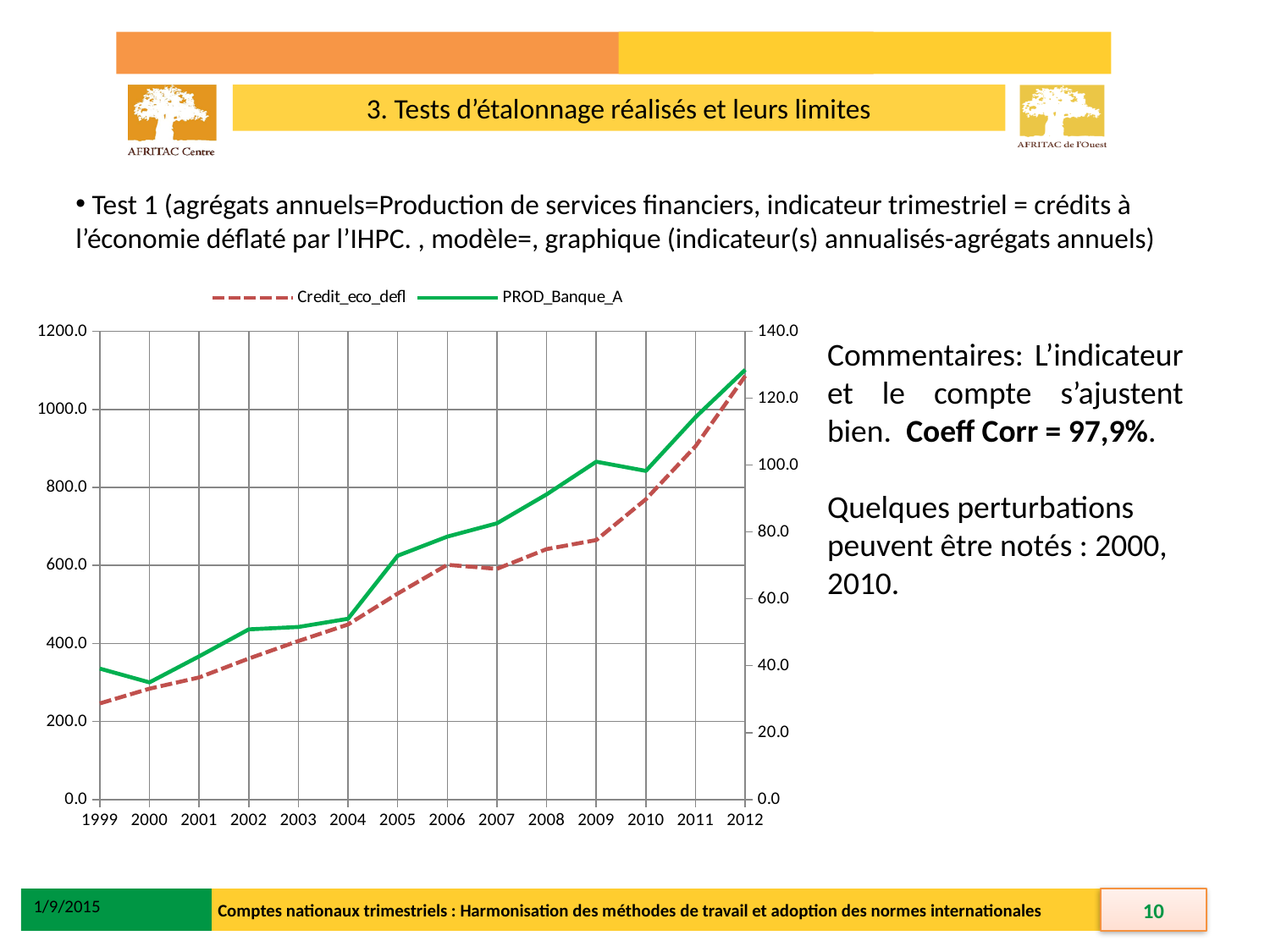
What kind of chart is shown on the slide? line chart What is the first year shown on the x axis of the chart? 1999 Between 2009 and 2010, does the PROD_Banque_A line rise or fall? fall Overall, do the values of the PROD_Banque_A series rise or fall from 1999 to 2012? rise Read against the left axis, is the Credit_eco_defl value for 1999 greater or less than 400? less Overall, do the values of the Credit_eco_defl series rise or fall from 1999 to 2012? rise What are the names of the two series in the chart legend? Credit_eco_defl and PROD_Banque_A How many series does the chart legend list? 2 Which series is drawn as a dashed line in the chart? Credit_eco_defl How many years are plotted along the x axis of the chart? 14 Read against the left axis, is the Credit_eco_defl value for 2012 greater or less than 1000? greater